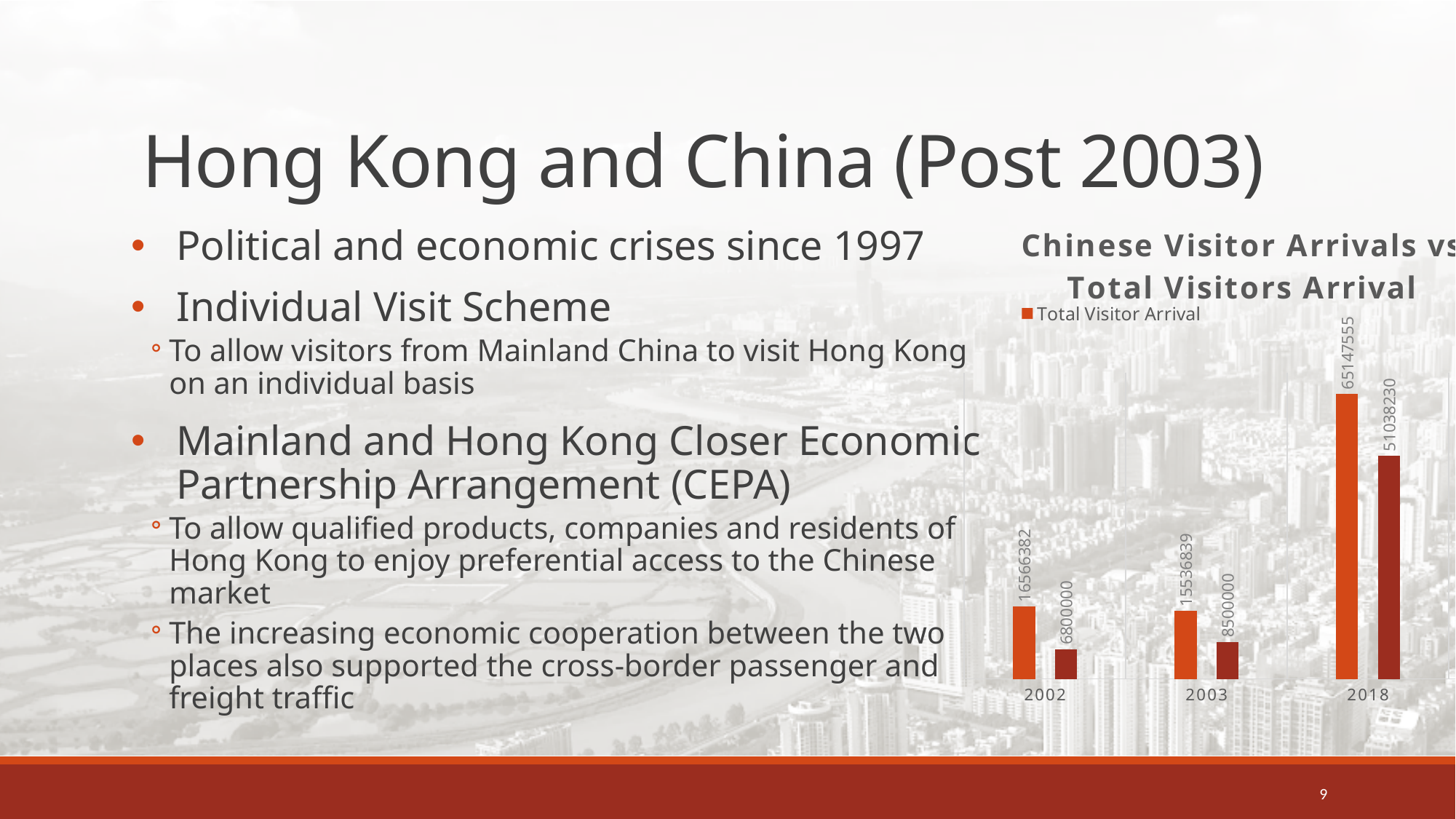
How many years are shown on the x axis of the chart? 3 What is the value printed on the dark red bar for 2018? 51038230 What type of chart is shown on the slide? bar chart Which year has the highest Total Visitor Arrival? 2018 What is the value printed on the dark red bar for 2002? 6800000 Which series name is readable in the chart's legend? Total Visitor Arrival Is the Total Visitor Arrival for 2018 larger or smaller than for 2002? larger What is the Total Visitor Arrival value for 2002? 16566382 Which year has the lowest Total Visitor Arrival? 2003 What is the difference between the Total Visitor Arrival values for 2002 and 2003? 1029543 What is the Total Visitor Arrival value for 2018? 65147555 What is the Total Visitor Arrival value for 2003? 15536839